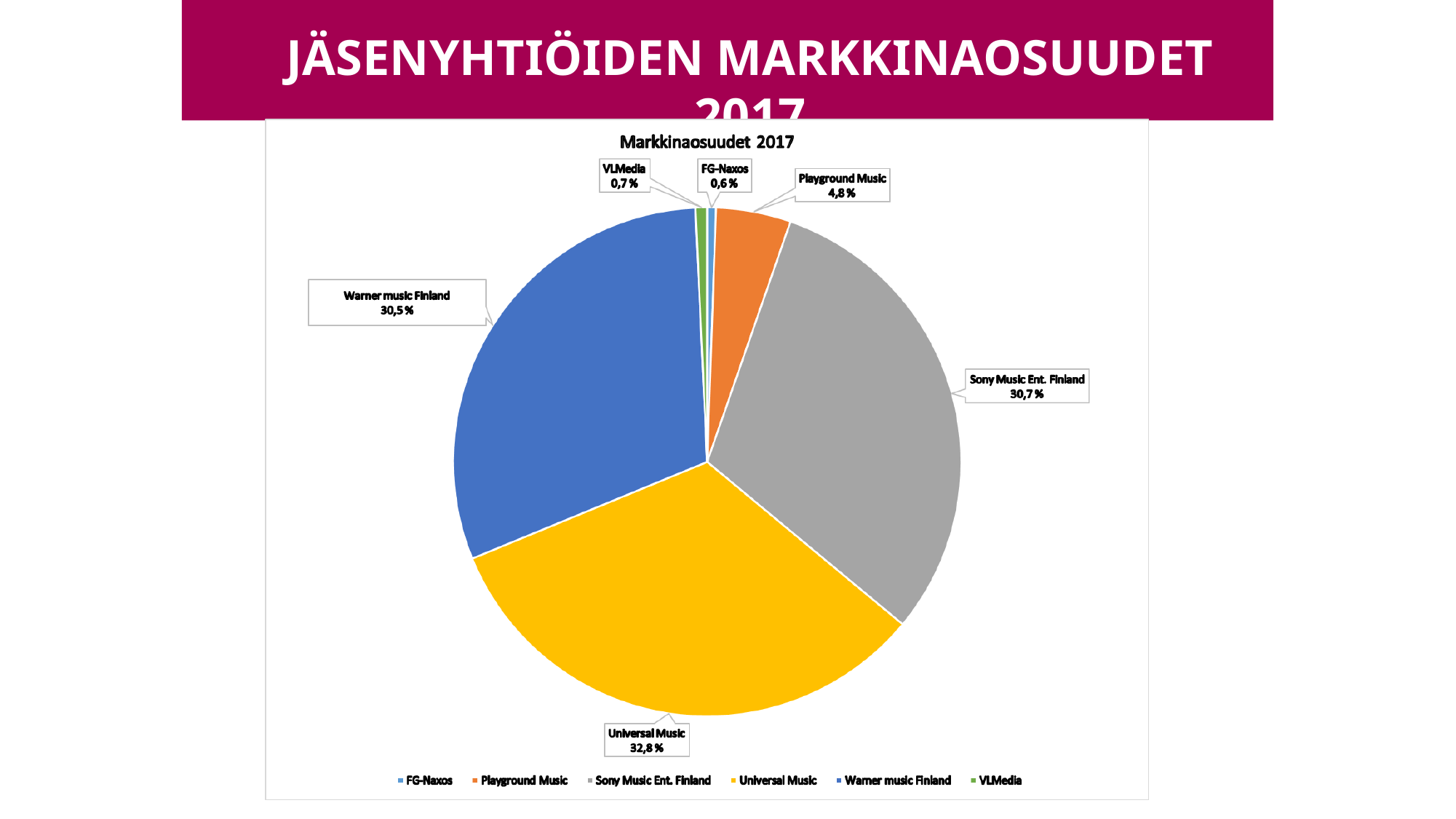
What is the difference in market share between Universal Music and Sony Music Ent. Finland? 2,1 % How many companies are shown as slices in the pie chart? 6 What is the market share shown for Sony Music Ent. Finland? 30,7 % What is the difference in market share between Playground Music and VLMedia? 4,1 % Which has a larger market share, Warner music Finland or Playground Music? Warner music Finland What is the market share shown for VLMedia? 0,7 % Which company has the smallest slice of the pie? FG-Naxos What is the market share shown for Playground Music? 4,8 % What kind of chart is shown on the slide? Pie chart What is the market share shown for Universal Music? 32,8 % What is the title of the chart? Markkinaosuudet 2017 Which company has the largest slice of the pie? Universal Music